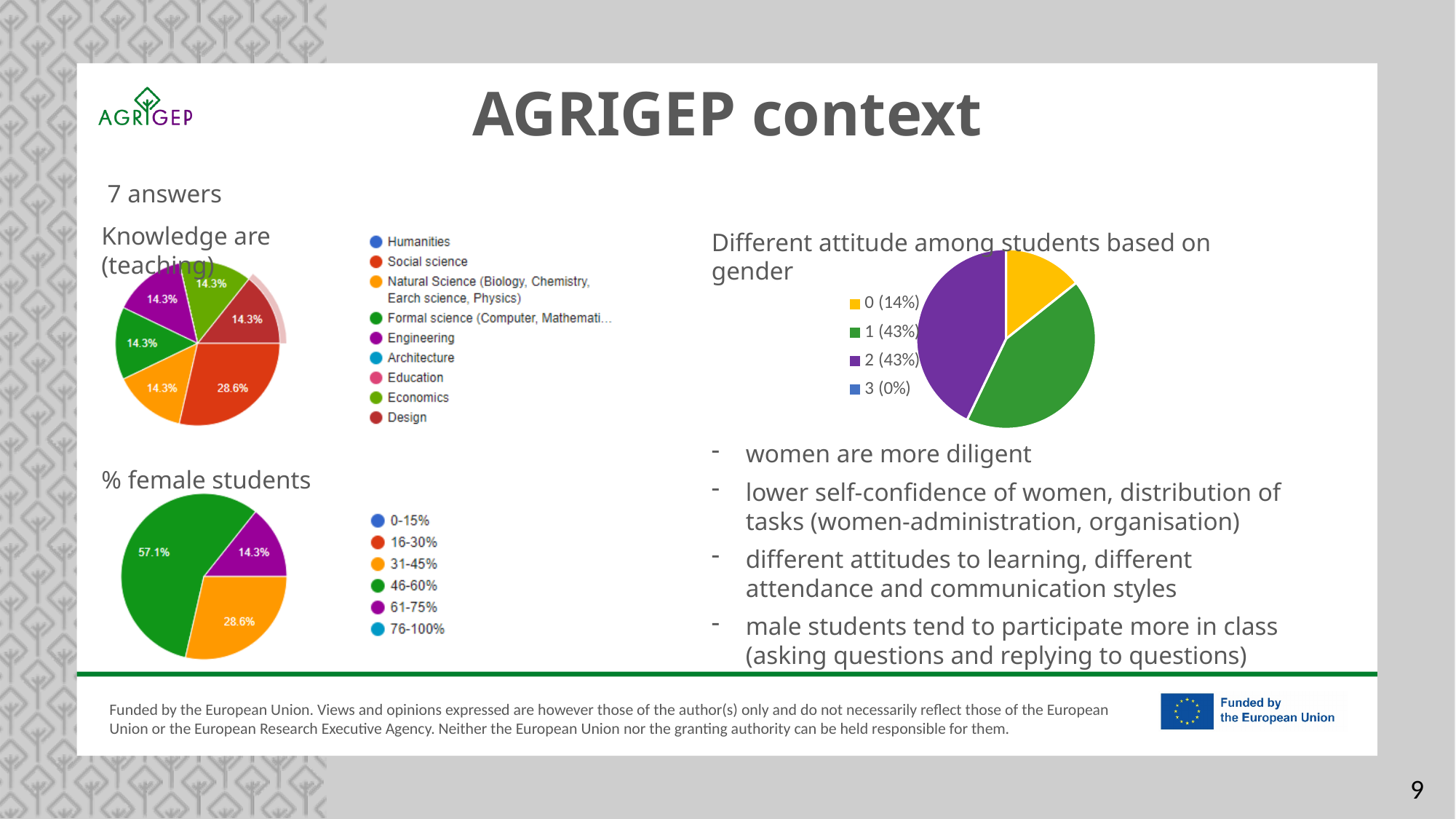
In the '% female students' pie chart, which is larger: the 31-45% slice or the 61-75% slice? 31-45% In the '% female students' pie chart, what share does the 46-60% category have? 57.1% What kind of chart is used for 'Knowledge are (teaching)'? Pie chart In the 'Knowledge are (teaching)' pie chart, what share does Social science have? 28.6% In the 'Different attitude among students based on gender' pie chart, what share does category 3 have? 0% In the 'Knowledge are (teaching)' pie chart, which category has the largest slice? Social science In the 'Different attitude among students based on gender' pie chart, what share does category 1 have? 43% In the '% female students' pie chart, which category has the smallest slice? 61-75% In the 'Knowledge are (teaching)' pie chart, what is the difference between the Social science slice and the Engineering slice? 14.3% How many entries does the legend of the 'Knowledge are (teaching)' pie chart list? 9 In the 'Different attitude among students based on gender' pie chart, what is the difference between the share of category 2 and the share of category 0? 29% How many entries does the legend of the '% female students' pie chart list? 6